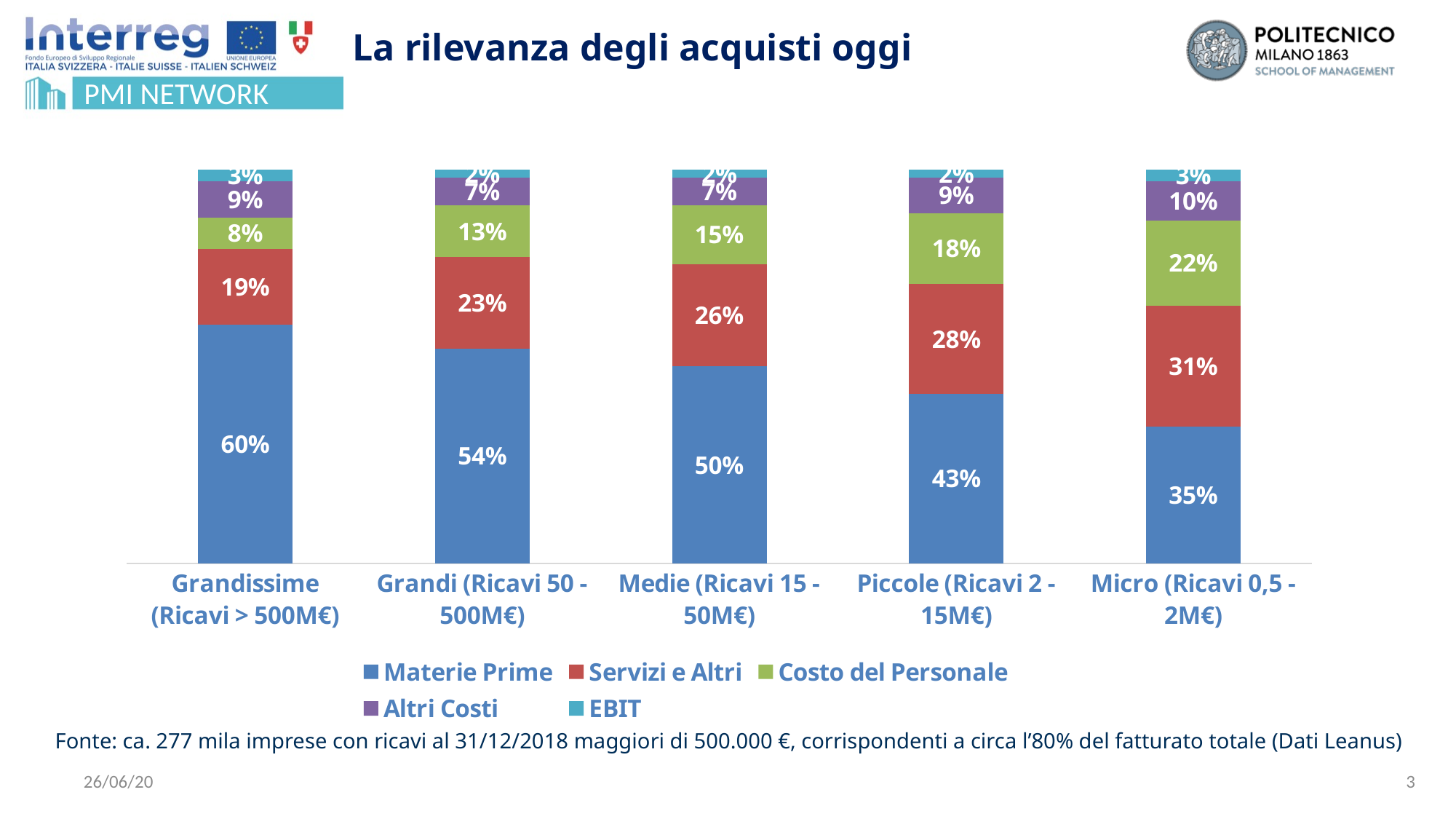
What is the difference between the Materie Prime share for Grandissime (Ricavi > 500M€) and for Micro (Ricavi 0,5 - 2M€)? 25% What kind of chart is shown on the slide? stacked bar chart What is the Altri Costi share for Medie (Ricavi 15 - 50M€)? 7% Does the Materie Prime share rise or fall moving from Grandissime to Micro along the x axis? fall Which category has the highest Materie Prime share? Grandissime (Ricavi > 500M€) What is the Materie Prime share for Grandissime (Ricavi > 500M€)? 60% How many series does the legend list? 5 Which is larger: the Costo del Personale share for Grandi (Ricavi 50 - 500M€) or for Medie (Ricavi 15 - 50M€)? Medie (Ricavi 15 - 50M€) What is the Servizi e Altri share for Micro (Ricavi 0,5 - 2M€)? 31% What is the Costo del Personale share for Piccole (Ricavi 2 - 15M€)? 18% Which category has the lowest Materie Prime share? Micro (Ricavi 0,5 - 2M€) How many company size categories are shown on the x axis? 5